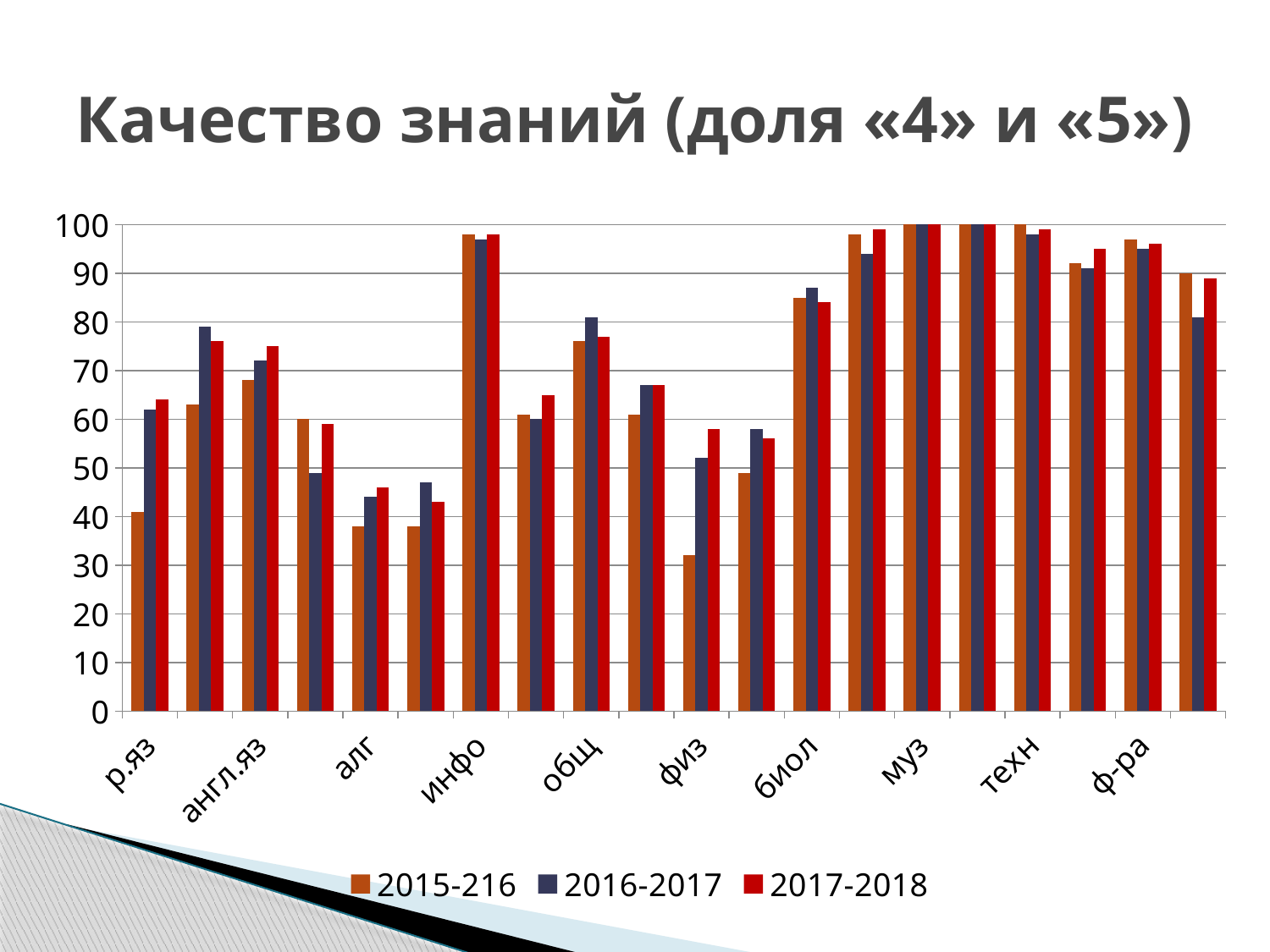
Is the value for р.яз in the 2015-216 series greater or less than 50? less Is the value for инфо in the 2016-2017 series greater or less than 90? greater What is the title of the chart? Качество знаний (доля «4» и «5») Which series is shown in red in the legend? 2017-2018 Is the value for физ in the 2015-216 series greater or less than 40? less How many series does the legend list? 3 For р.яз, do the values rise or fall from 2015-216 to 2017-2018? rise Which category has the lowest value in the 2015-216 series? физ What is the value for муз in the 2015-216 series? 100 What kind of chart is shown on the slide? bar chart For физ, which is larger: the 2015-216 value or the 2017-2018 value? 2017-2018 What is the value for техн in the 2015-216 series? 100